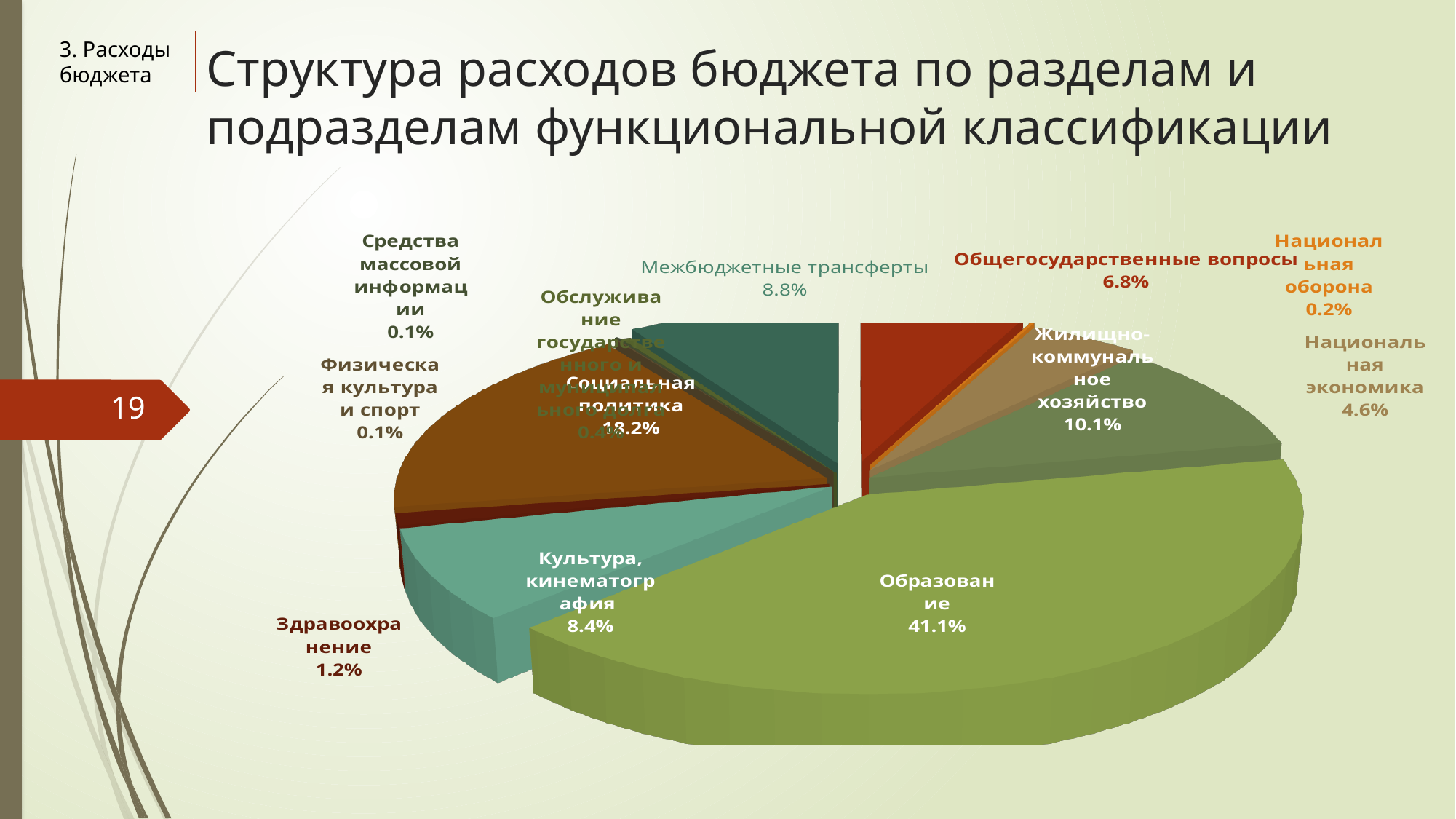
What is the share for Образование? 41.1% What is the share for Межбюджетные трансферты? 8.8% What is the share for Национальная оборона? 0.2% What is the difference between the shares for Образование and Социальная политика? 22.9% How many categories are shown in the pie chart? 12 What is the difference between the shares for Общегосударственные вопросы and Национальная экономика? 2.2% What kind of chart is shown on the slide? pie chart Which is larger: the share for Межбюджетные трансферты or the share for Культура, кинематография? Межбюджетные трансферты Which category has the largest share of the pie? Образование What is the share for Здравоохранение? 1.2% What is the share for Жилищно-коммунальное хозяйство? 10.1% What is the share for Социальная политика? 18.2%